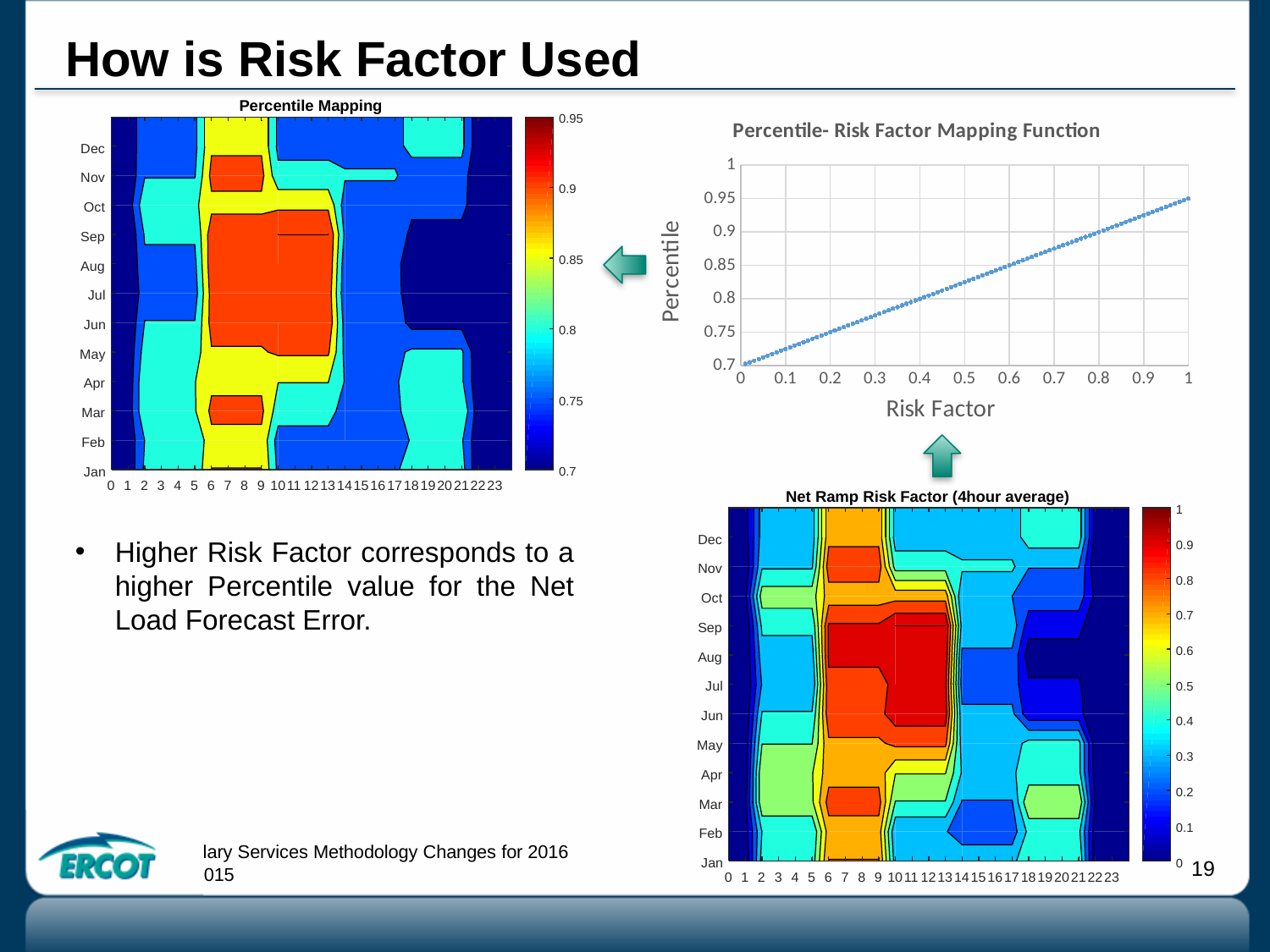
In the 'Percentile- Risk Factor Mapping Function' chart, does the percentile rise or fall as the risk factor increases? rises In the 'Percentile- Risk Factor Mapping Function' chart, is the percentile at a risk factor of 0.2 greater or less than 0.8? less In the 'Percentile- Risk Factor Mapping Function' chart, is the percentile at a risk factor of 0.5 greater or less than 0.8? greater In the 'Percentile- Risk Factor Mapping Function' chart, which has the higher percentile: a risk factor of 0.3 or a risk factor of 0.7? 0.7 What is the highest value shown on the colour bar of the 'Net Ramp Risk Factor (4hour average)' chart? 1 In the 'Percentile- Risk Factor Mapping Function' chart, is the percentile at a risk factor of 0.9 greater or less than 0.9? greater In the 'Percentile- Risk Factor Mapping Function' chart, what is the percentile value at a risk factor of 0? 0.7 What is the x-axis title of the 'Percentile- Risk Factor Mapping Function' chart? Risk Factor In the 'Percentile- Risk Factor Mapping Function' chart, what is the percentile value at a risk factor of 1? 0.95 What kind of chart is the 'Percentile- Risk Factor Mapping Function' chart? scatter chart How many months are labelled on the y axis of the 'Net Ramp Risk Factor (4hour average)' chart? 12 How many hour values (0 to 23) are labelled on the x axis of the 'Percentile Mapping' chart? 24